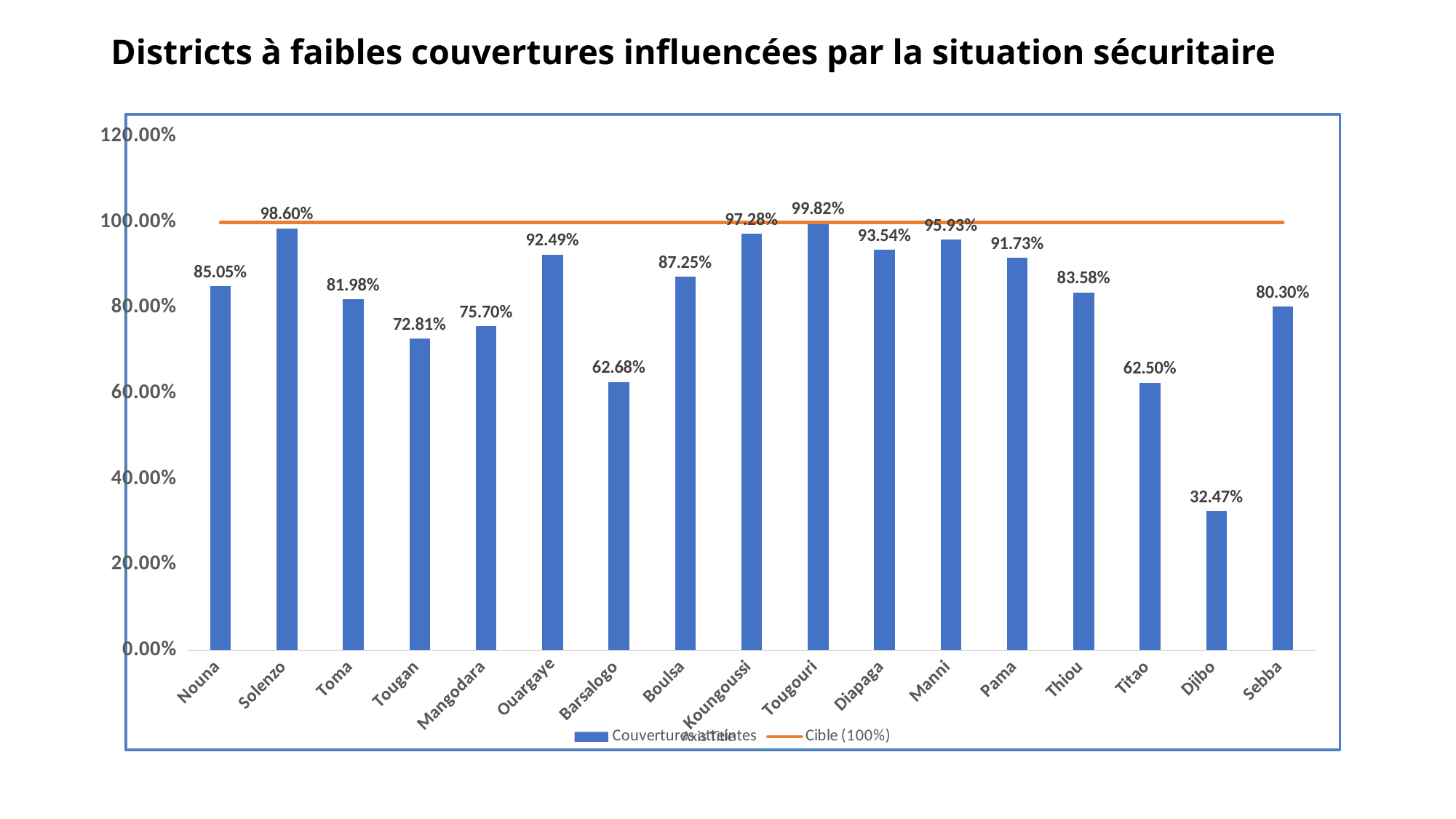
What is the difference between the coverage values for Solenzo and Nouna? 13.55 percentage points What is the title of the chart? Districts à faibles couvertures influencées par la situation sécuritaire What kind of chart is shown on the slide? Bar chart with a target line What is the coverage value shown for Mangodara? 75.70% Which district has the highest coverage value? Tougouri What is the difference between the coverage values for Sebba and Djibo? 47.83 percentage points How many districts are shown on the x axis? 17 Which district has the lowest coverage value? Djibo Which has a higher coverage value, Boulsa or Thiou? Boulsa How many series does the legend list? 2 What is the coverage value shown for Djibo? 32.47% What is the coverage value shown for Tougouri? 99.82%